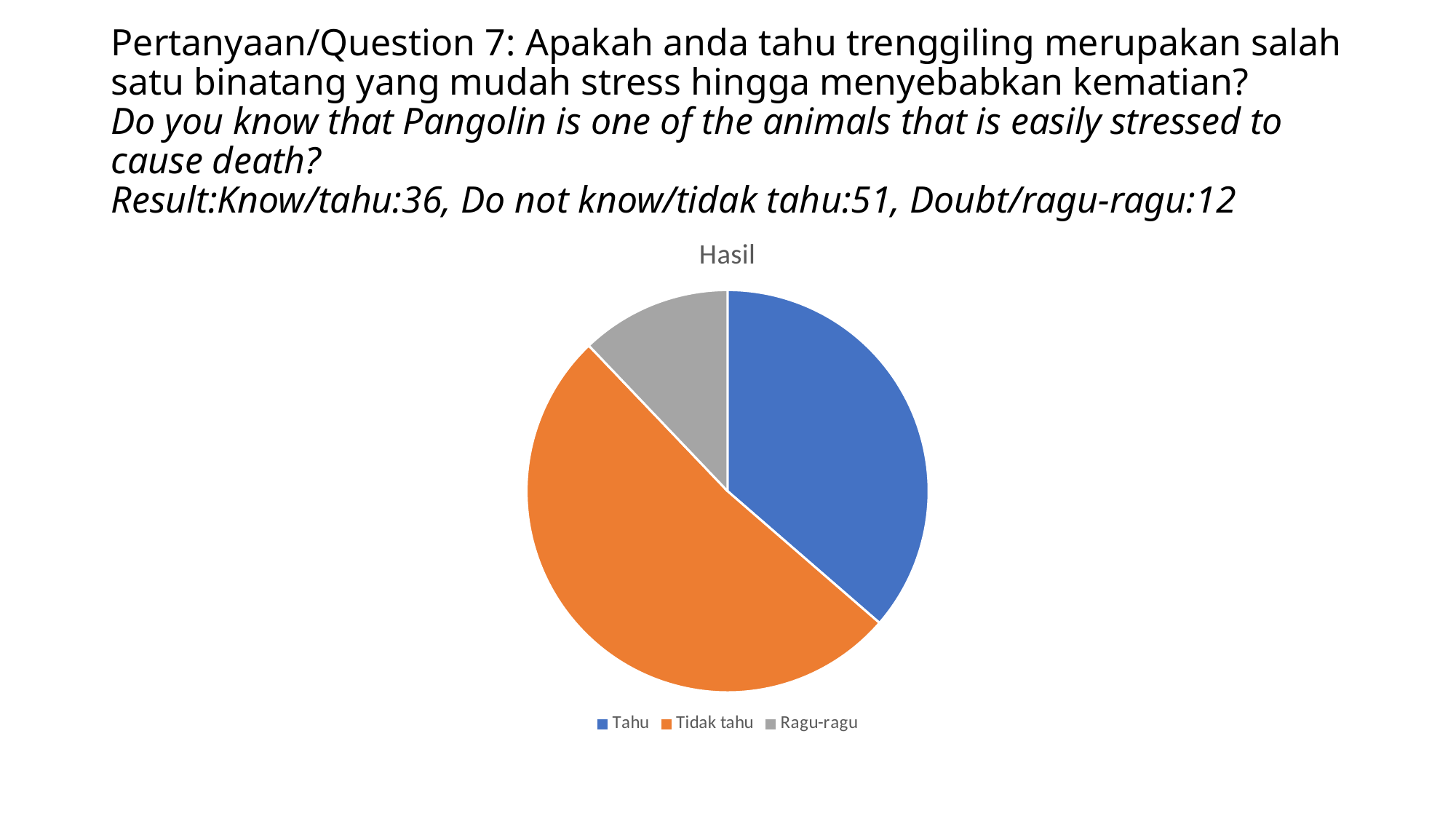
What colour is the Tidak tahu slice in the pie chart? orange What is the value for Ragu-ragu (Doubt)? 12 How many slices does the pie chart have? 3 Which category has the smallest slice of the pie? Ragu-ragu Which category has the largest slice of the pie? Tidak tahu What is the title of the chart? Hasil How many entries does the chart legend list? 3 What is the value for Tidak tahu (Do not know)? 51 What is the value for Tahu (Know)? 36 What kind of chart is shown on the slide? pie chart What is the difference between the Tidak tahu value and the Tahu value? 15 Which is larger, the Tahu slice or the Ragu-ragu slice? Tahu